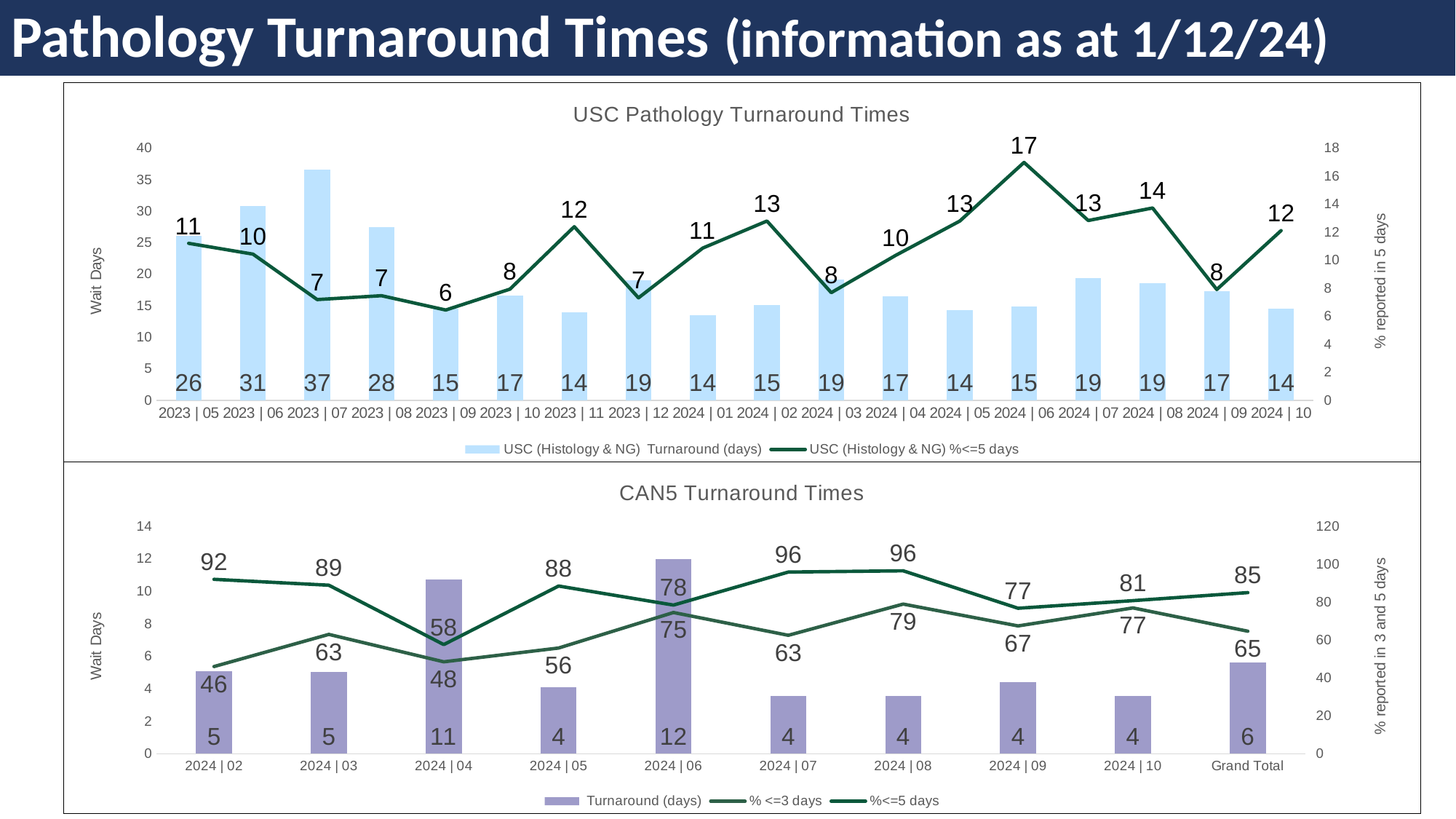
In the USC Pathology Turnaround Times chart, what is the USC (Histology & NG) %<=5 days value for 2024 | 06? 17 How many series does the legend of the CAN5 Turnaround Times chart list? 3 In the CAN5 Turnaround Times chart, what is the Turnaround (days) value for 2024 | 06? 12 In the CAN5 Turnaround Times chart, what is the %<=5 days value for Grand Total? 85 In the USC Pathology Turnaround Times chart, what is the difference between the Turnaround (days) values for 2023 | 06 and 2023 | 05? 5 In the USC Pathology Turnaround Times chart, which month has the highest USC (Histology & NG) Turnaround (days) value? 2023 | 07 In the CAN5 Turnaround Times chart, what is the % <=3 days value for 2024 | 08? 79 How many months are shown on the x axis of the USC Pathology Turnaround Times chart? 18 What kind of chart is the CAN5 Turnaround Times chart? Combined bar and line chart In the USC Pathology Turnaround Times chart, what is the USC (Histology & NG) Turnaround (days) value for 2023 | 07? 37 In the USC Pathology Turnaround Times chart, which month has the lowest USC (Histology & NG) %<=5 days value? 2023 | 09 In the CAN5 Turnaround Times chart, which is larger: the %<=5 days value for 2024 | 02 or for 2024 | 04? 2024 | 02